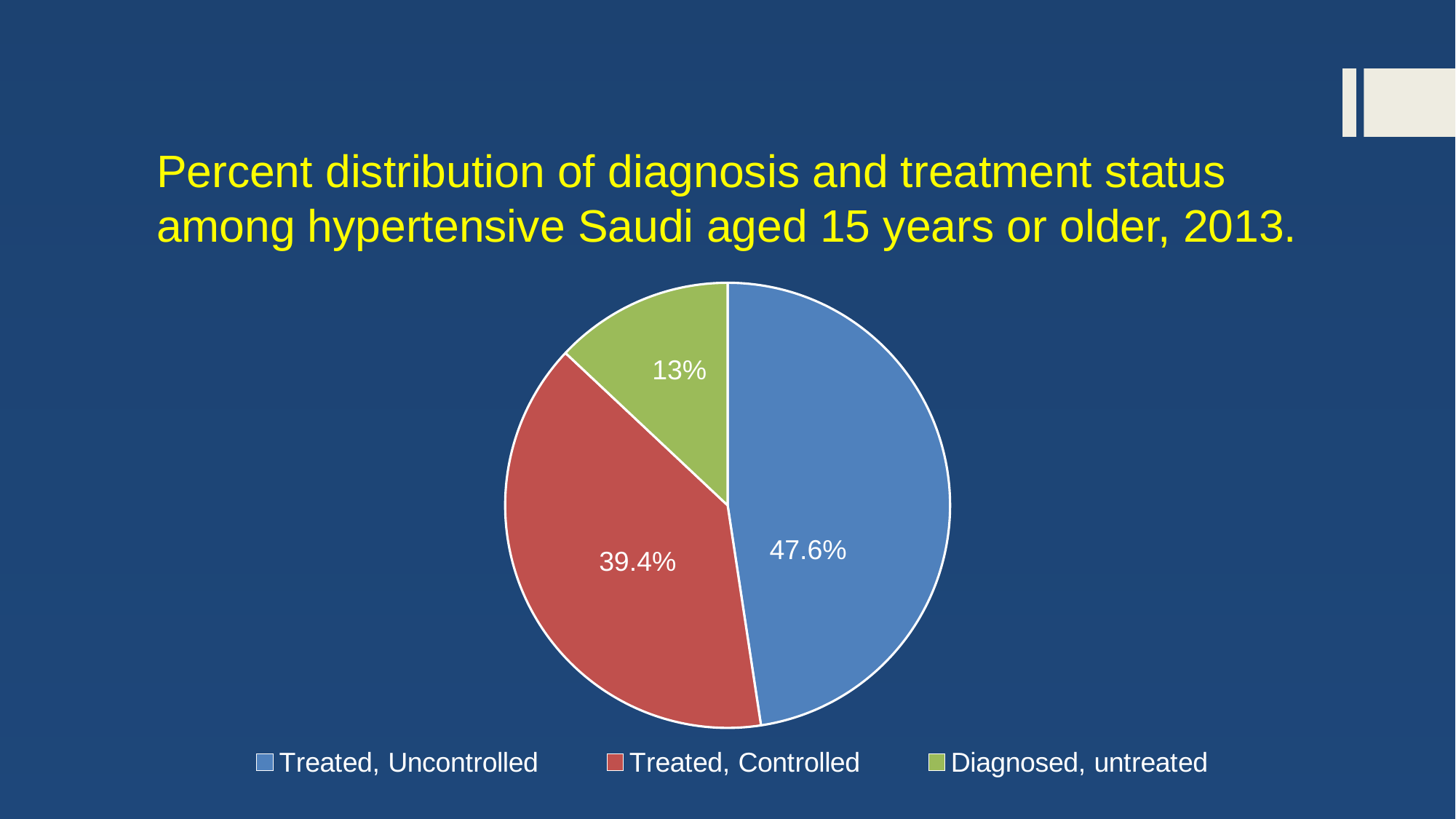
What colour is the slice for Diagnosed, untreated? Green What is the title of the chart on the slide? Percent distribution of diagnosis and treatment status among hypertensive Saudi aged 15 years or older, 2013. How many entries does the legend list? 3 Which category has the smallest slice of the pie? Diagnosed, untreated What percentage of the pie is labelled for Treated, Uncontrolled? 47.6% What percentage of the pie is labelled for Treated, Controlled? 39.4% What percentage of the pie is labelled for Diagnosed, untreated? 13% Which category has the largest slice of the pie? Treated, Uncontrolled Which is larger: the slice for Treated, Controlled or the slice for Diagnosed, untreated? Treated, Controlled What is the difference in percentage points between Treated, Uncontrolled and Treated, Controlled? 8.2 How many slices does the pie chart have? 3 What kind of chart is shown on the slide? Pie chart